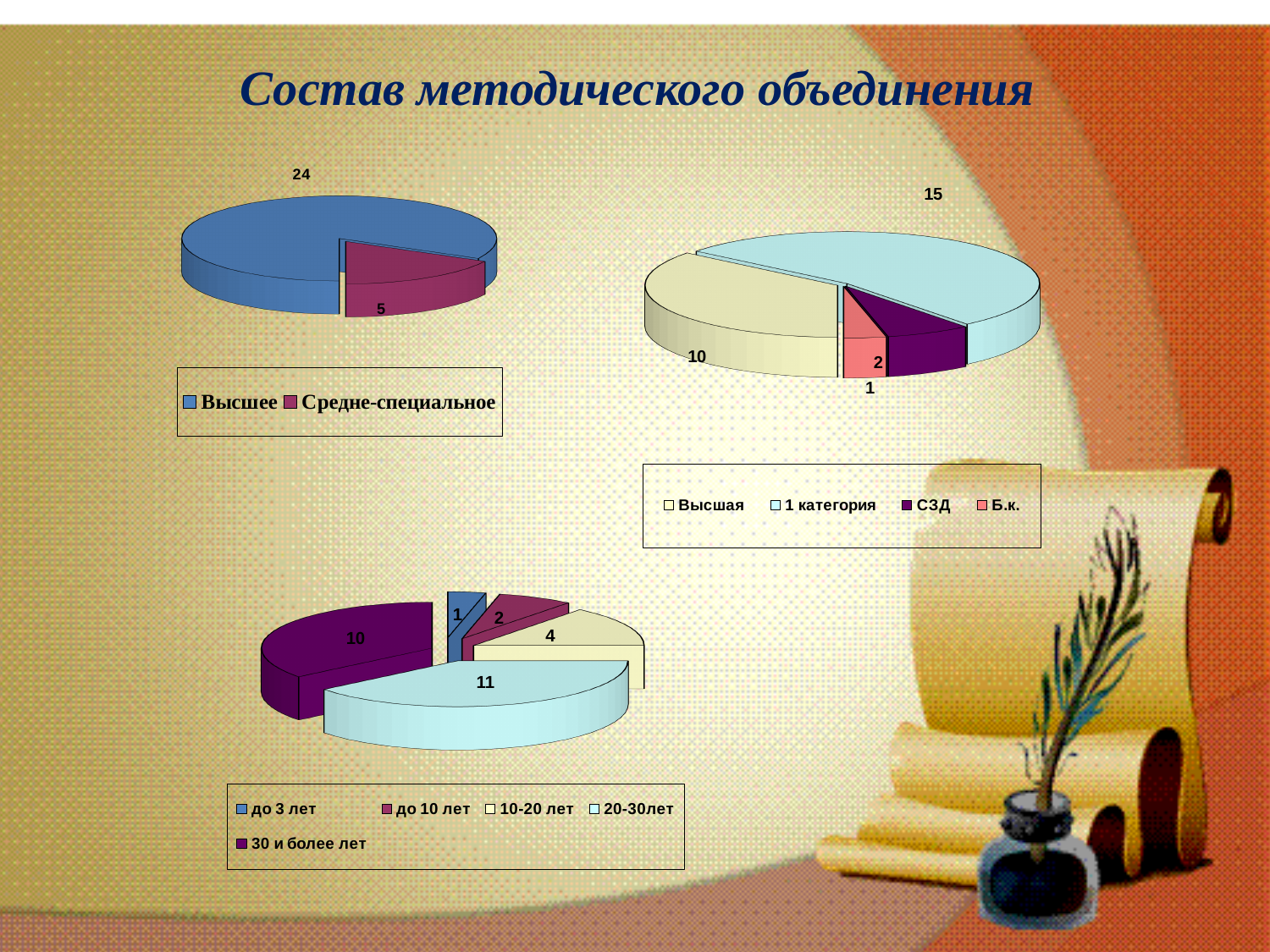
In the bottom-left pie chart, what is the value for 20-30лет? 11 In the bottom-left pie chart, which is larger: 10-20 лет or до 10 лет? 10-20 лет In the bottom-left pie chart, which category has the highest value? 20-30лет In the top-right pie chart, how many categories does the legend list? 4 What kind of chart is the top-left chart? Pie chart In the top-right pie chart, what is the value for 1 категория? 15 In the top-left pie chart, what is the difference between Высшее and Средне-специальное? 19 In the top-left pie chart, what is the value for Средне-специальное? 5 In the top-left pie chart, what is the value for Высшее? 24 In the bottom-left pie chart, how many categories does the legend list? 5 In the top-right pie chart, what is the total of all slices? 28 In the top-right pie chart, which category has the lowest value? Б.к.